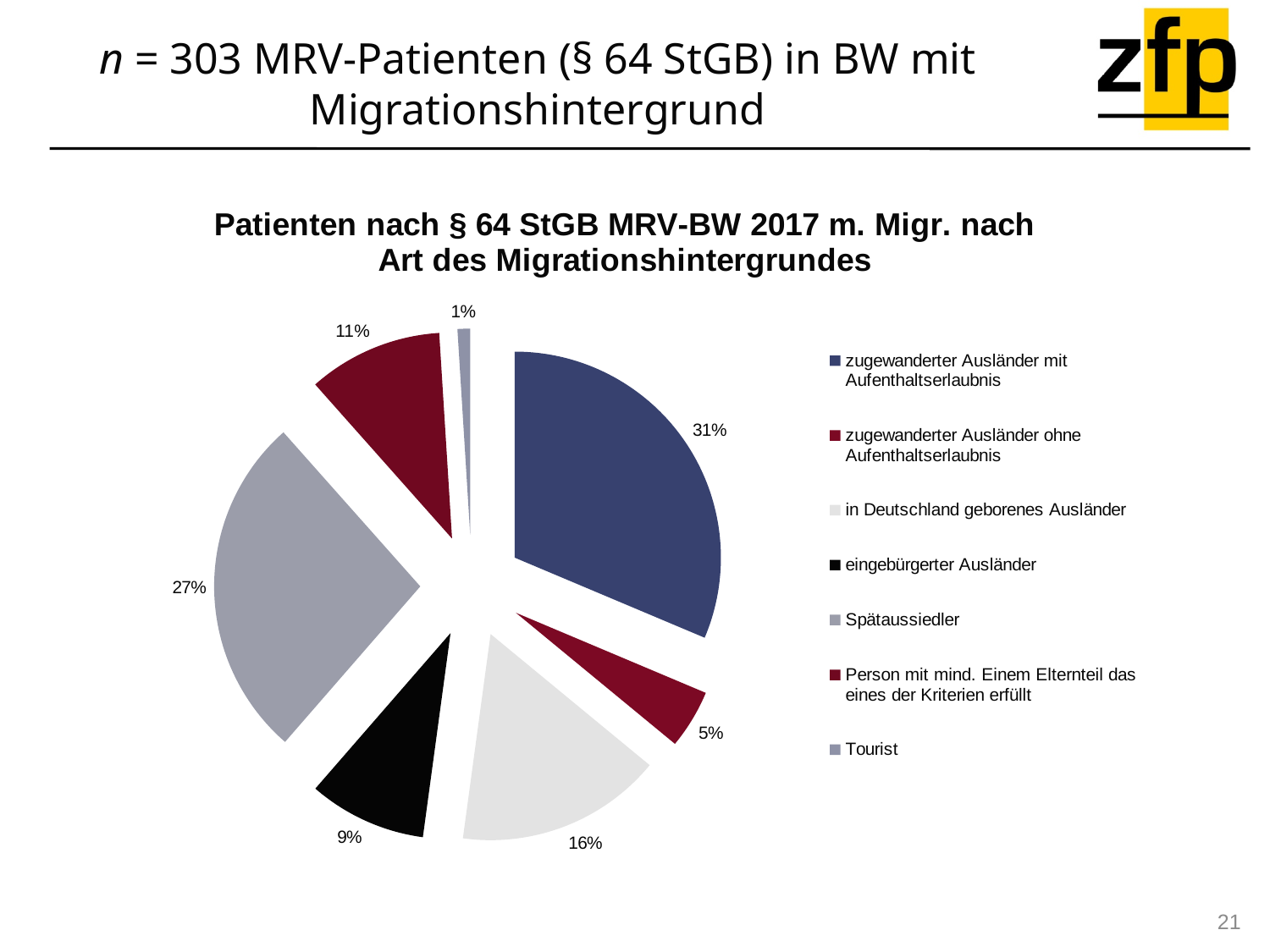
What percentage is shown for 'in Deutschland geborenes Ausländer'? 16% Which is larger: the share for 'Person mit mind. Einem Elternteil das eines der Kriterien erfüllt' or the share for 'eingebürgerter Ausländer'? Person mit mind. Einem Elternteil das eines der Kriterien erfüllt What type of chart is shown on the slide? Pie chart What percentage is shown for 'eingebürgerter Ausländer'? 9% Which category has the smallest slice of the pie? Tourist How many categories does the legend list? 7 What is the difference in percentage points between 'zugewanderter Ausländer mit Aufenthaltserlaubnis' and 'Spätaussiedler'? 4 percentage points What is the title of the chart? Patienten nach § 64 StGB MRV-BW 2017 m. Migr. nach Art des Migrationshintergrundes What percentage is shown for 'Spätaussiedler'? 27% What percentage is shown for 'Tourist'? 1% What share of the pie does 'zugewanderter Ausländer mit Aufenthaltserlaubnis' represent? 31% Which category has the largest slice of the pie? zugewanderter Ausländer mit Aufenthaltserlaubnis